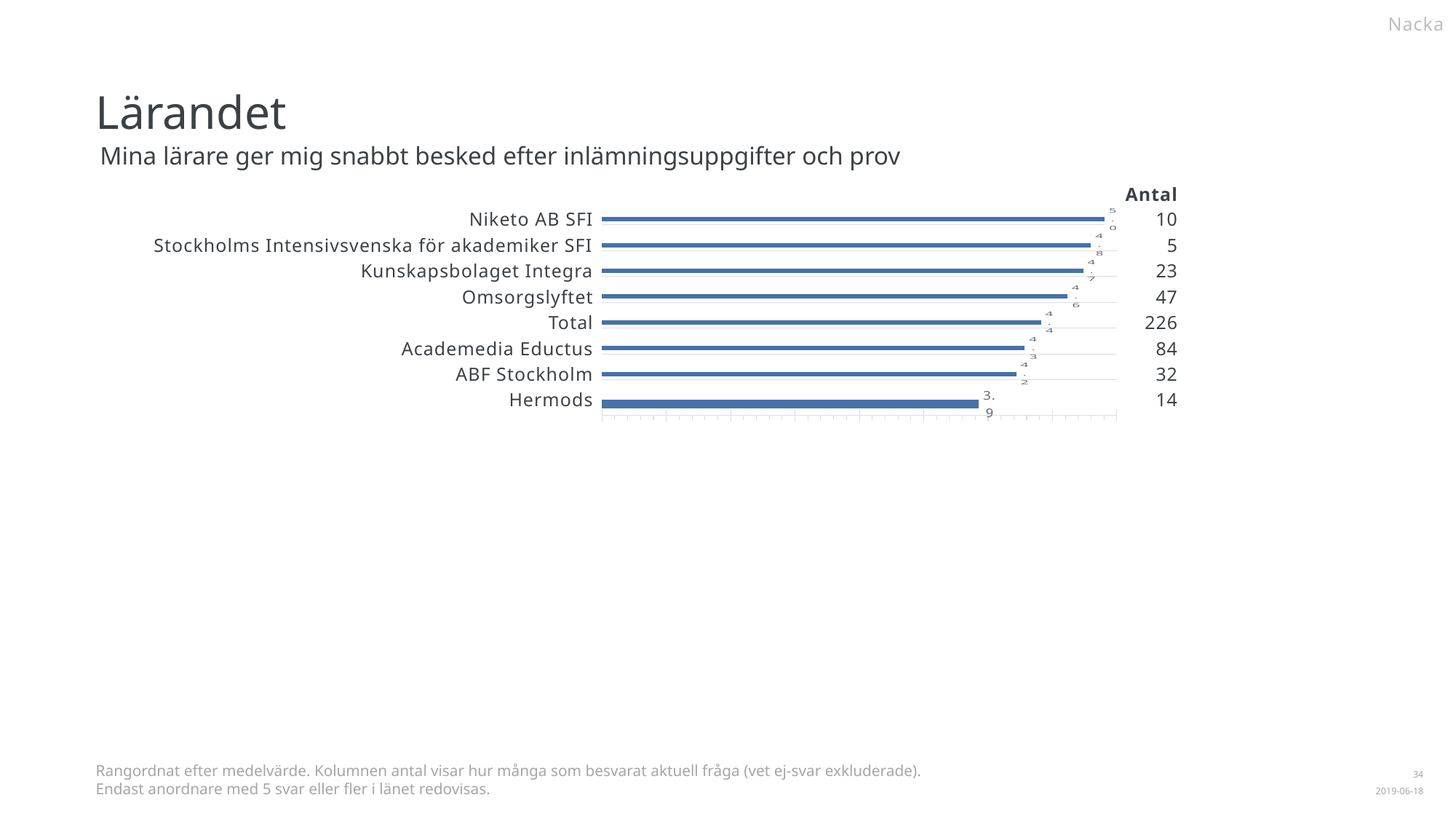
What is the value for Hermods? 3.9 What is the difference between the values for Niketo AB SFI and Hermods? 1.1 What is the value for Niketo AB SFI? 5.0 What is the Antal (number of respondents) shown for Total? 226 Which category has the highest value in the chart? Niketo AB SFI How many categories (bars) does the chart show? 8 What is the value for Total? 4.4 Which has a larger value, Omsorgslyftet or ABF Stockholm? Omsorgslyftet What is the Antal shown for Academedia Eductus? 84 Which category has the lowest value in the chart? Hermods What is the subtitle (question text) shown above the chart? Mina lärare ger mig snabbt besked efter inlämningsuppgifter och prov What type of chart is shown on the slide? bar chart